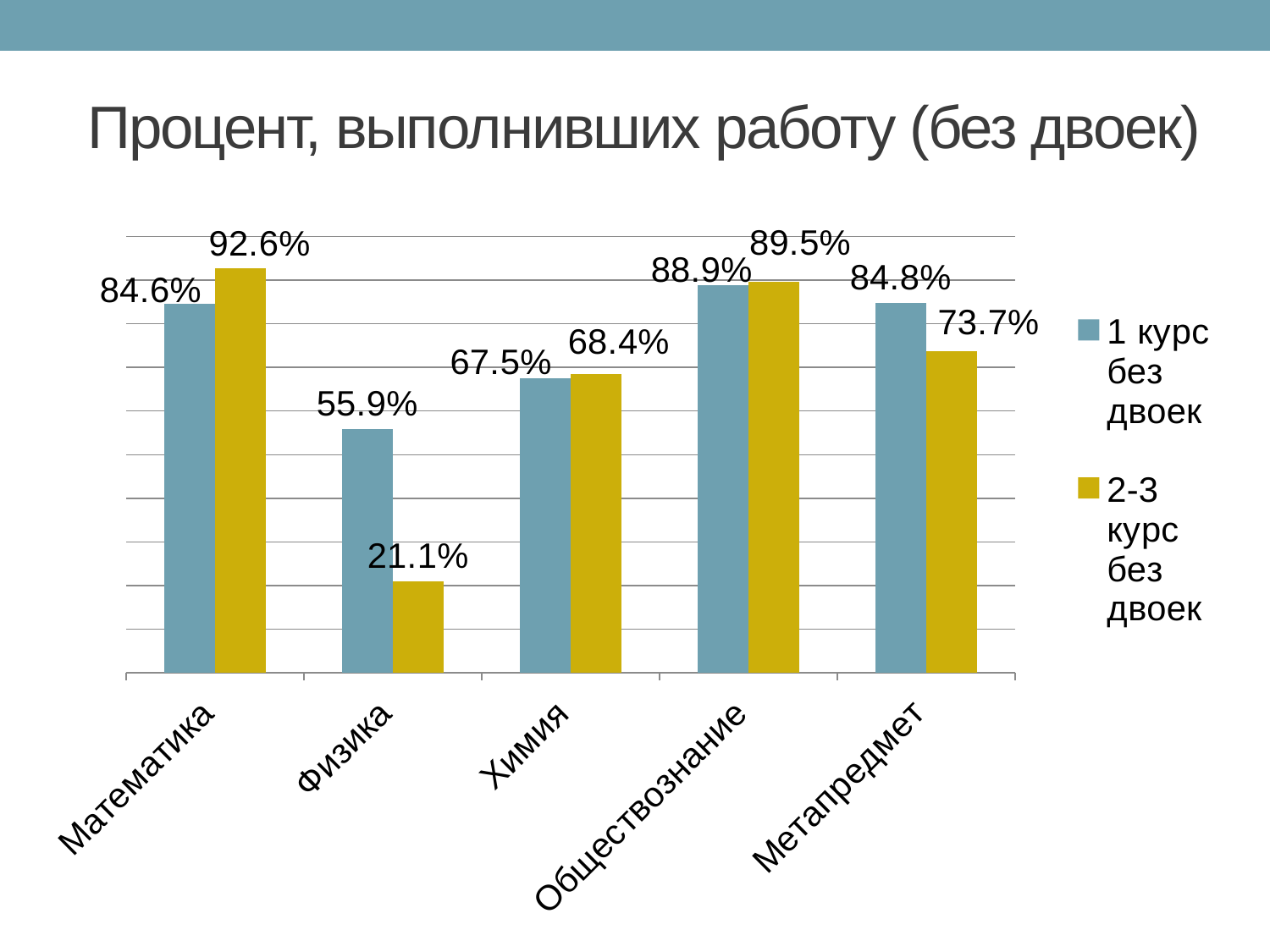
What is the title of the chart? Процент, выполнивших работу (без двоек) What kind of chart is shown on the slide? Bar chart What is the difference between the two series for Физика? 34.8% What is the value for Метапредмет in the series "2-3 курс без двоек"? 73.7% Which category has the highest value in the series "2-3 курс без двоек"? Математика What is the difference between the two series for Химия? 0.9% How many series does the legend list? 2 What is the value for Физика in the series "2-3 курс без двоек"? 21.1% For Метапредмет, which series has the larger value? 1 курс без двоек How many categories are shown on the x axis? 5 What is the value for Математика in the series "1 курс без двоек"? 84.6% Which category has the lowest value in the series "1 курс без двоек"? Физика